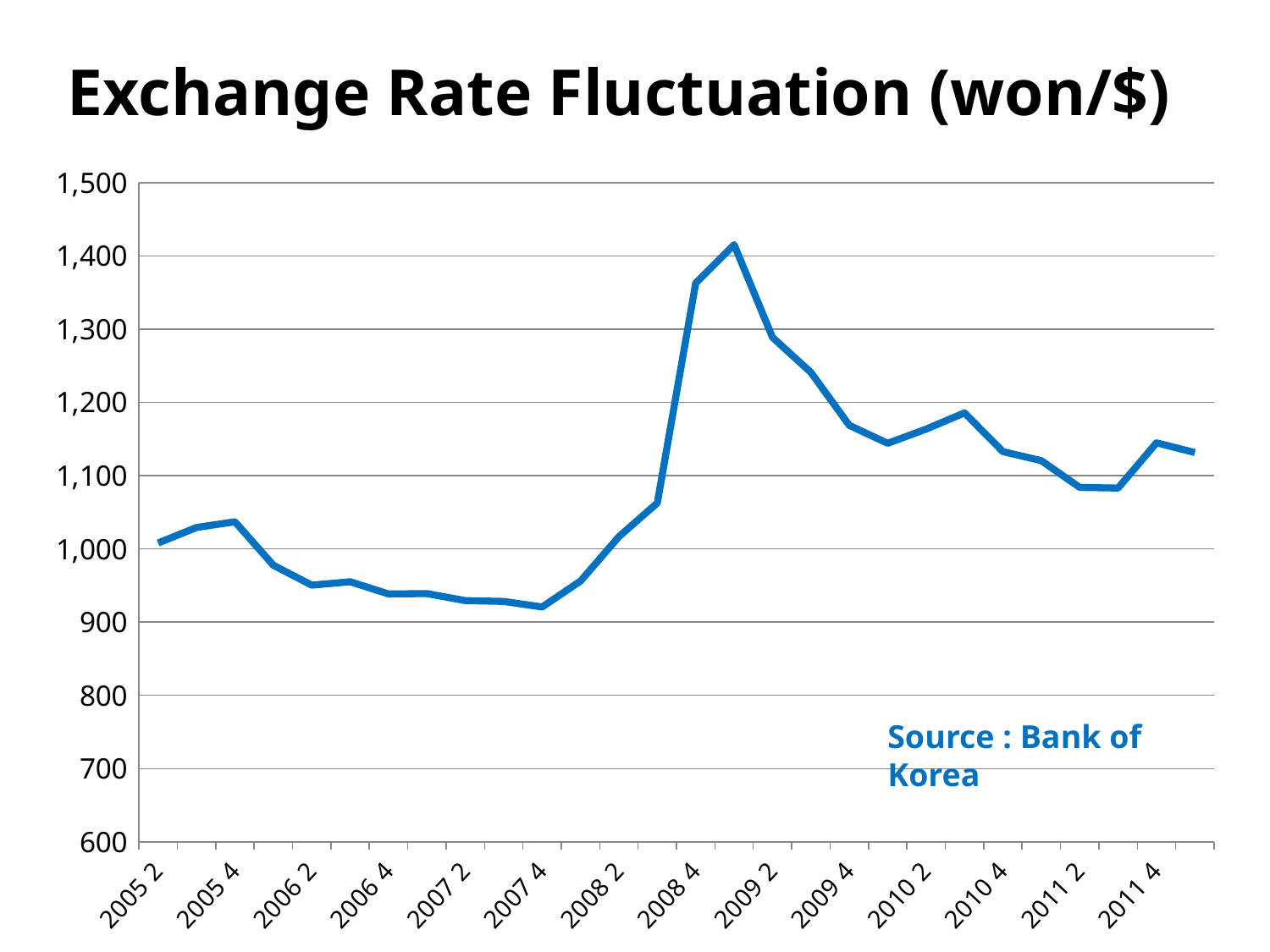
Which is larger, the value for 2008 4 or the value for 2005 2? 2008 4 Which of the labelled periods has the lowest exchange rate? 2007 4 Is the value for 2010 2 greater or less than 1,100? greater Is the value for 2008 4 greater or less than 1,300? greater What type of chart is shown on the slide? Line chart Is the value for 2006 4 greater or less than 1,000? less Does the exchange rate rise or fall between 2005 4 and 2007 4? Fall Does the exchange rate rise or fall between 2007 4 and 2008 4? Rise What source is cited for the chart data? Bank of Korea What is the title of the chart? Exchange Rate Fluctuation (won/$)